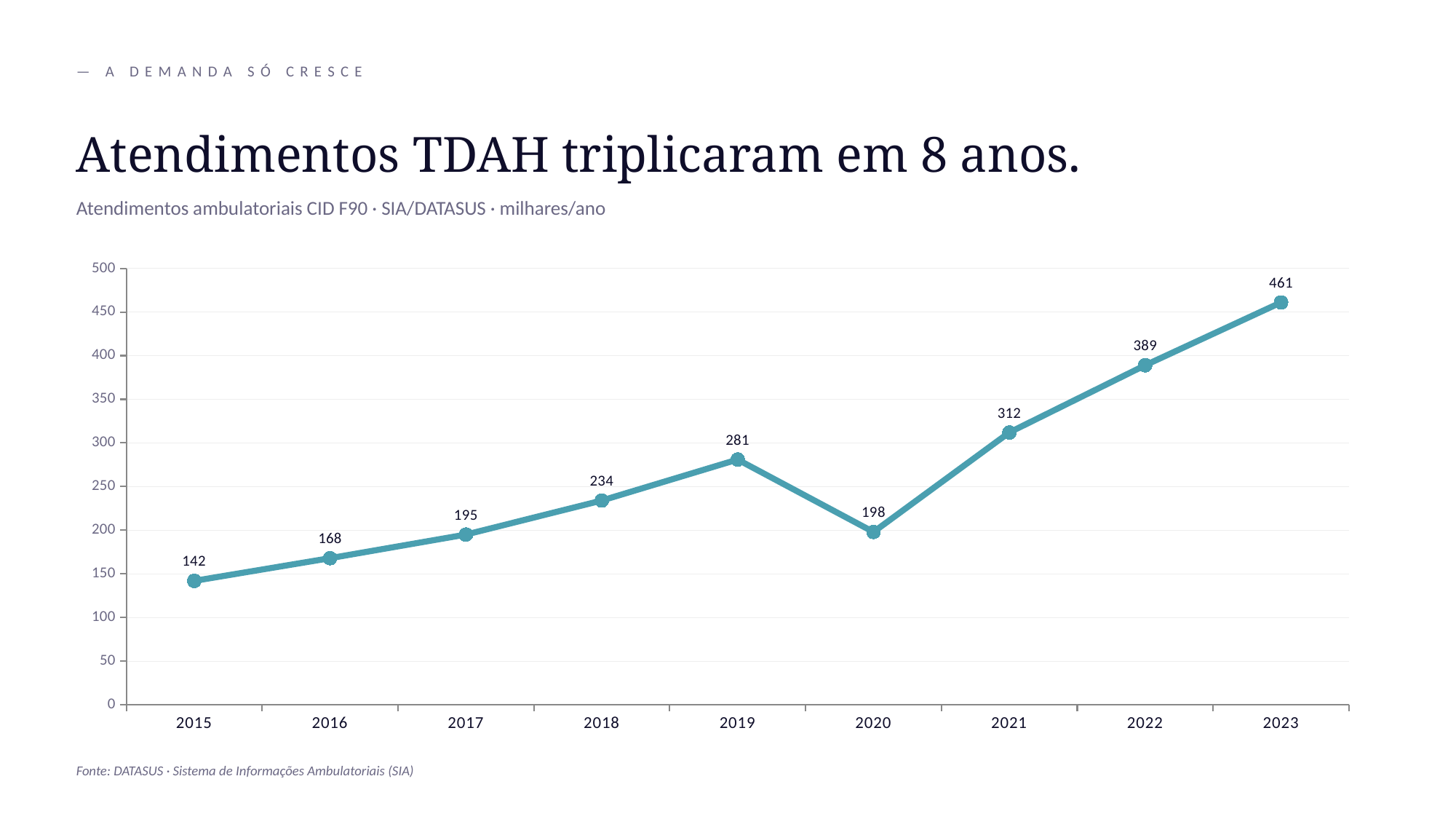
What is the difference between the values for 2023 and 2015? 319 How many years are plotted on the chart? 9 Is the value for 2021 greater or less than 300? greater Between 2020 and 2023, do the values rise or fall? rise What is the value for 2015? 142 What kind of chart is shown on the slide? line chart Which is larger, the value for 2019 or the value for 2020? 2019 What is the value for 2019? 281 Which year has the lowest value? 2015 What is the value for 2022? 389 What is the difference between the values for 2019 and 2020? 83 Which year has the highest value? 2023